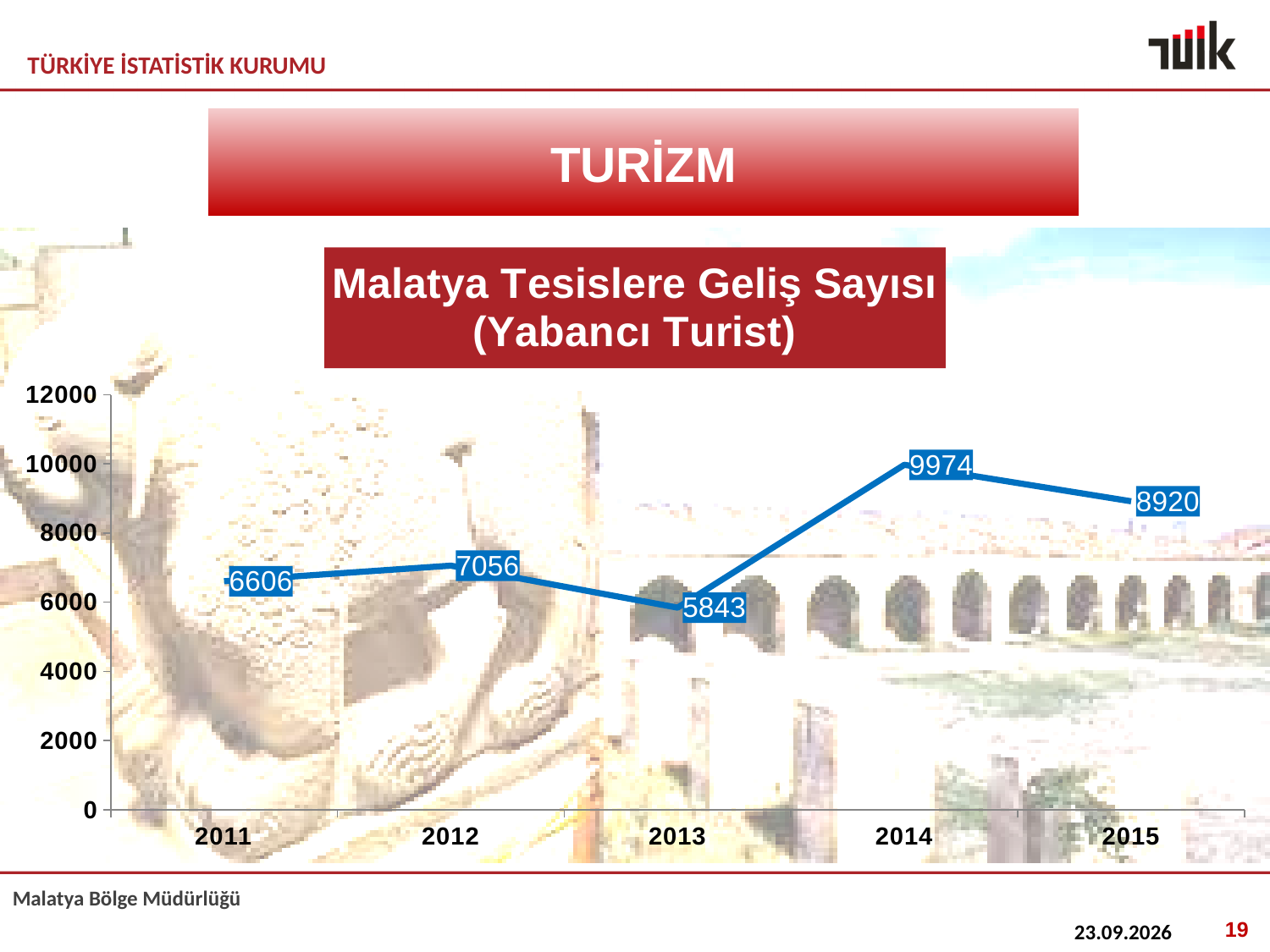
What is the value for 2015? 8920 What is the difference between the values for 2014 and 2015? 1054 How many years are plotted on the chart? 5 What is the value for 2013? 5843 What is the value for 2011? 6606 What is the difference between the values for 2012 and 2011? 450 What kind of chart is shown? line chart Which year has the lowest value? 2013 Which is larger, the value for 2012 or the value for 2013? 2012 Does the value rise or fall from 2013 to 2014? rise Is the value for 2014 greater or less than 8000? greater Which year has the highest value? 2014